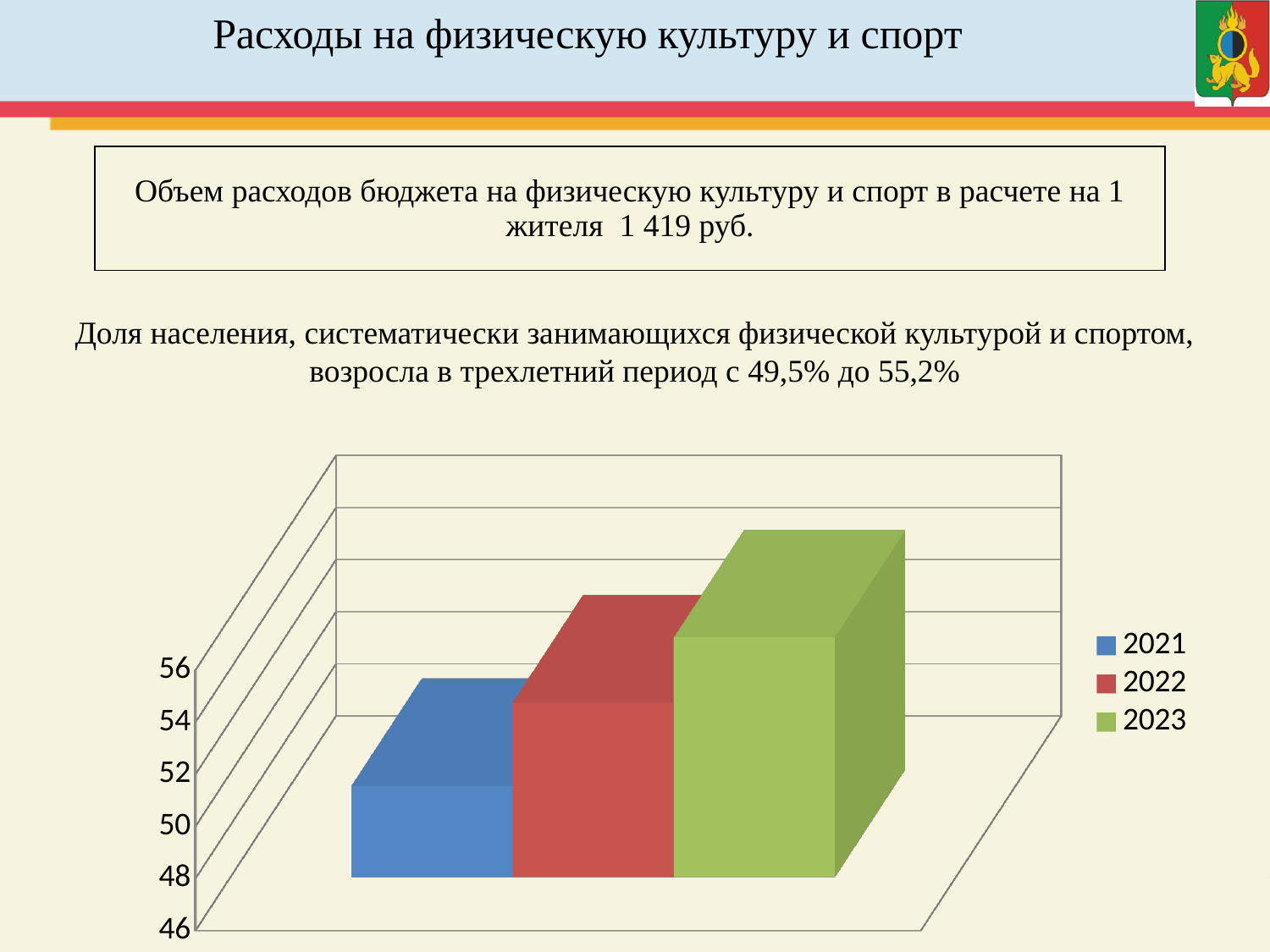
Do the bar values rise or fall from 2021 to 2023? rise Which bar is taller, 2021 or 2023? 2023 How many bars are plotted in the chart? 3 What kind of chart is shown on the slide? bar chart Which years are listed in the chart legend? 2021, 2022, 2023 Is the value for 2023 greater or less than 52? greater What colour is the bar for 2022 in the chart? red How many series does the chart legend list? 3 Is the value for 2021 greater or less than 54? less Which year has the lowest bar in the chart? 2021 Which bar is taller, 2022 or 2021? 2022 Which year has the highest bar in the chart? 2023